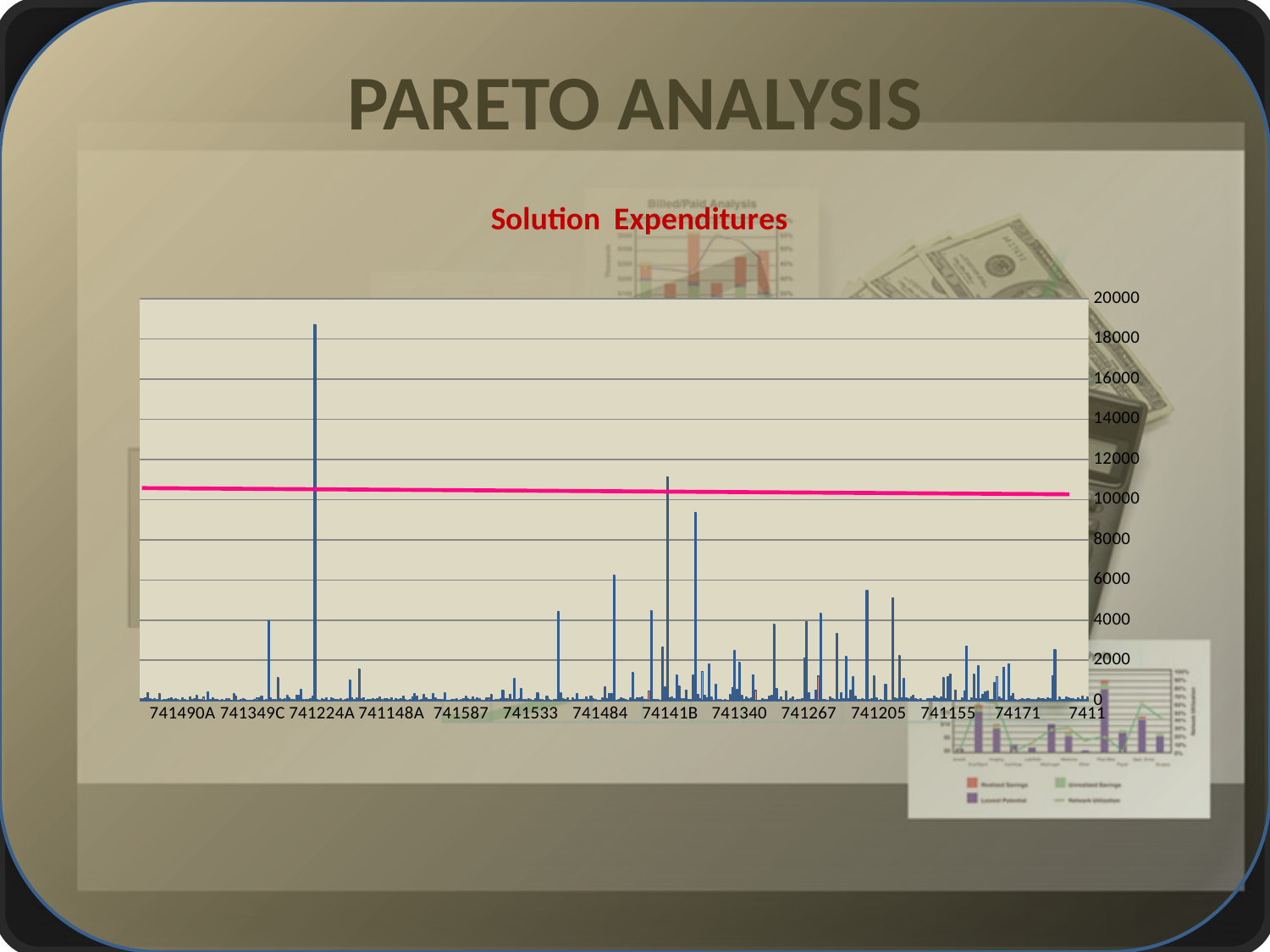
Does the pink line in the Solution Expenditures chart rise or fall from left to right? falls Is the tallest bar in the Solution Expenditures chart greater or less than 16000? greater Is the tallest bar in the Solution Expenditures chart greater or less than 18000? greater What is the first category label on the horizontal axis of the Solution Expenditures chart? 741490A Is the second-tallest bar in the Solution Expenditures chart (near the 74141B label) greater or less than 10000? greater What kind of chart is shown under the title "Solution Expenditures"? bar chart How many category labels are printed along the horizontal axis of the Solution Expenditures chart? 14 What is the title of the chart on the slide? Solution Expenditures What is the highest value shown on the vertical axis of the Solution Expenditures chart? 20000